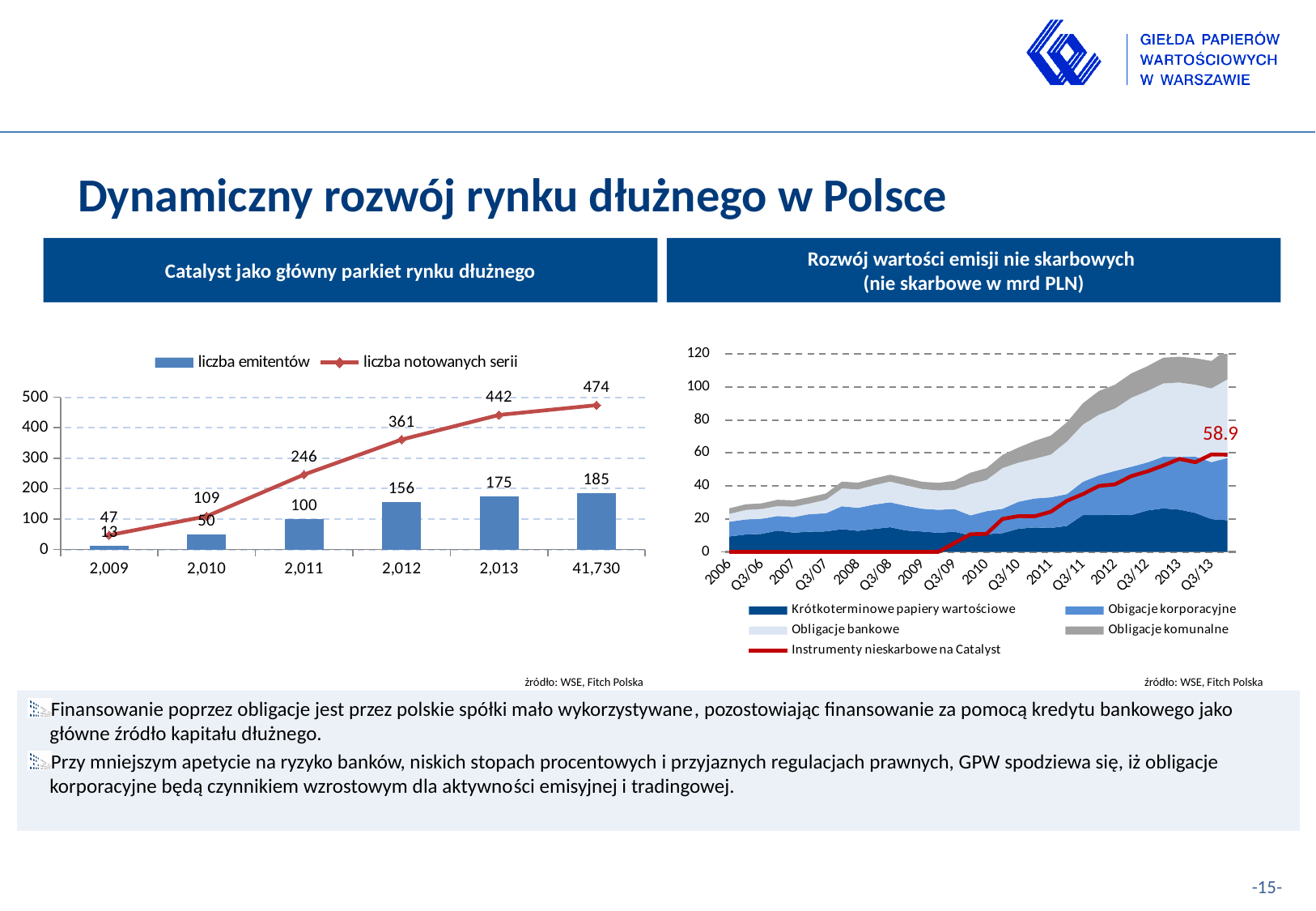
In the left chart 'Catalyst jako główny parkiet rynku dłużnego', how many series does the legend list? 2 In the left chart 'Catalyst jako główny parkiet rynku dłużnego', which category has the lowest value of 'liczba emitentów'? 2,009 In the right chart 'Rozwój wartości emisji nie skarbowych', how many series does the legend list? 5 In the left chart 'Catalyst jako główny parkiet rynku dłużnego', does 'liczba emitentów' rise or fall along the x axis? rise In the right chart 'Rozwój wartości emisji nie skarbowych', is the value of 'Instrumenty nieskarbowe na Catalyst' at Q3/13 greater or less than 40? greater In the right chart 'Rozwój wartości emisji nie skarbowych', what is the labelled value of 'Instrumenty nieskarbowe na Catalyst' at the end of the series? 58.9 In the left chart 'Catalyst jako główny parkiet rynku dłużnego', what is the difference between 'liczba notowanych serii' for 2,013 and 2,012? 81 In the left chart 'Catalyst jako główny parkiet rynku dłużnego', is 'liczba emitentów' larger for 2,010 or for 2,011? 2,011 In the left chart 'Catalyst jako główny parkiet rynku dłużnego', what is the value of 'liczba notowanych serii' for 2,011? 246 In the left chart 'Catalyst jako główny parkiet rynku dłużnego', how many categories are shown on the x axis? 6 In the left chart 'Catalyst jako główny parkiet rynku dłużnego', what is the value of 'liczba emitentów' for 2,012? 156 In the left chart 'Catalyst jako główny parkiet rynku dłużnego', which category has the highest value of 'liczba notowanych serii'? 41,730